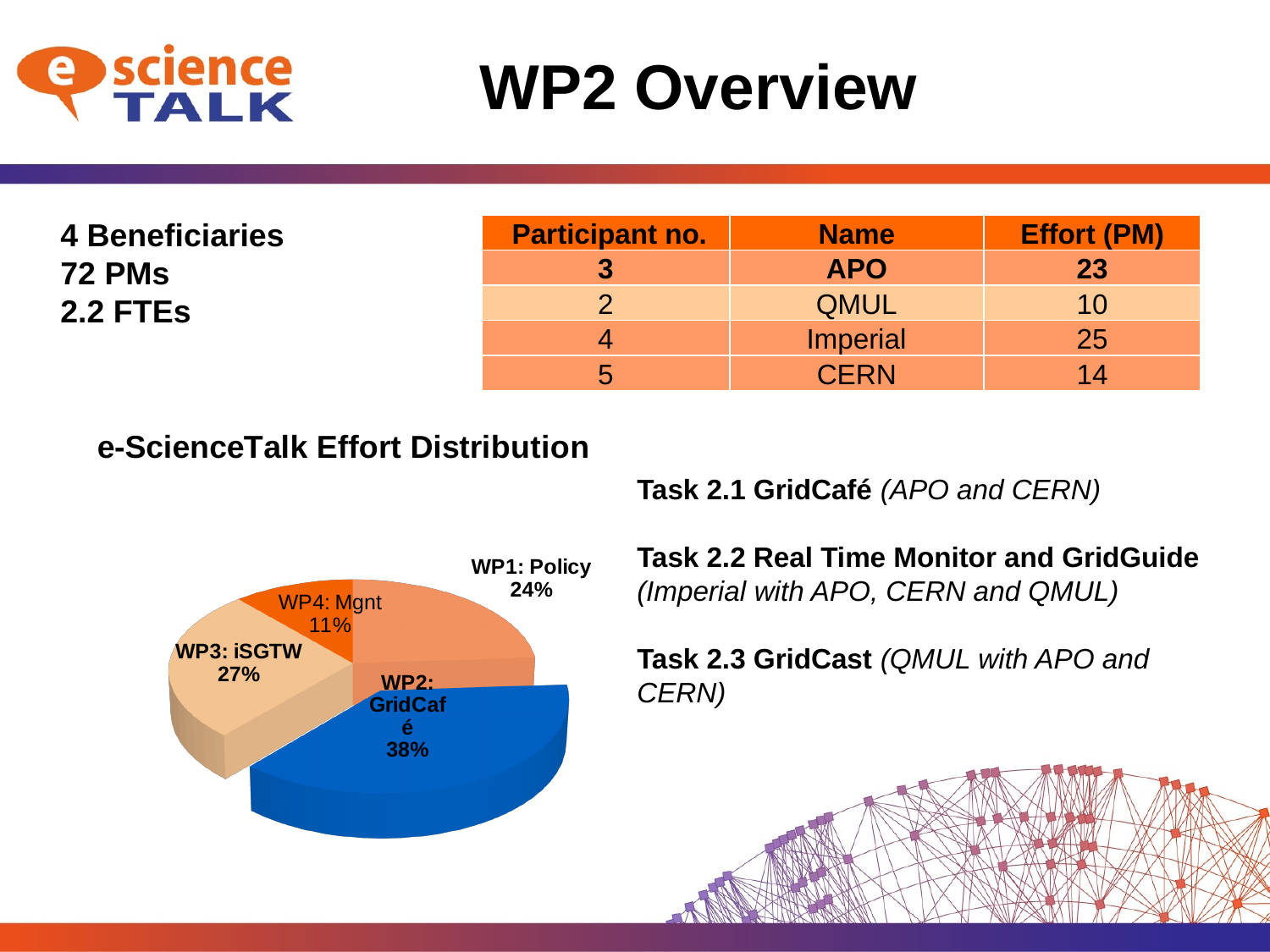
Which work package has the largest slice in the e-ScienceTalk Effort Distribution pie? WP2: GridCafé How many slices does the e-ScienceTalk Effort Distribution pie chart have? 4 In the e-ScienceTalk Effort Distribution pie, what is the difference in percentage points between WP2: GridCafé and WP1: Policy? 14 What share of the e-ScienceTalk Effort Distribution pie does WP1: Policy have? 24% In the e-ScienceTalk Effort Distribution pie, which is larger, WP3: iSGTW or WP1: Policy? WP3: iSGTW What share of the e-ScienceTalk Effort Distribution pie does WP3: iSGTW have? 27% What type of chart is the e-ScienceTalk Effort Distribution chart? Pie chart Which work package has the smallest slice in the e-ScienceTalk Effort Distribution pie? WP4: Mgnt What share of the e-ScienceTalk Effort Distribution pie does WP4: Mgnt have? 11% What share of the e-ScienceTalk Effort Distribution pie does WP2: GridCafé have? 38% What colour is the WP2: GridCafé slice in the e-ScienceTalk Effort Distribution pie? Blue What is the title of the chart on the slide? e-ScienceTalk Effort Distribution